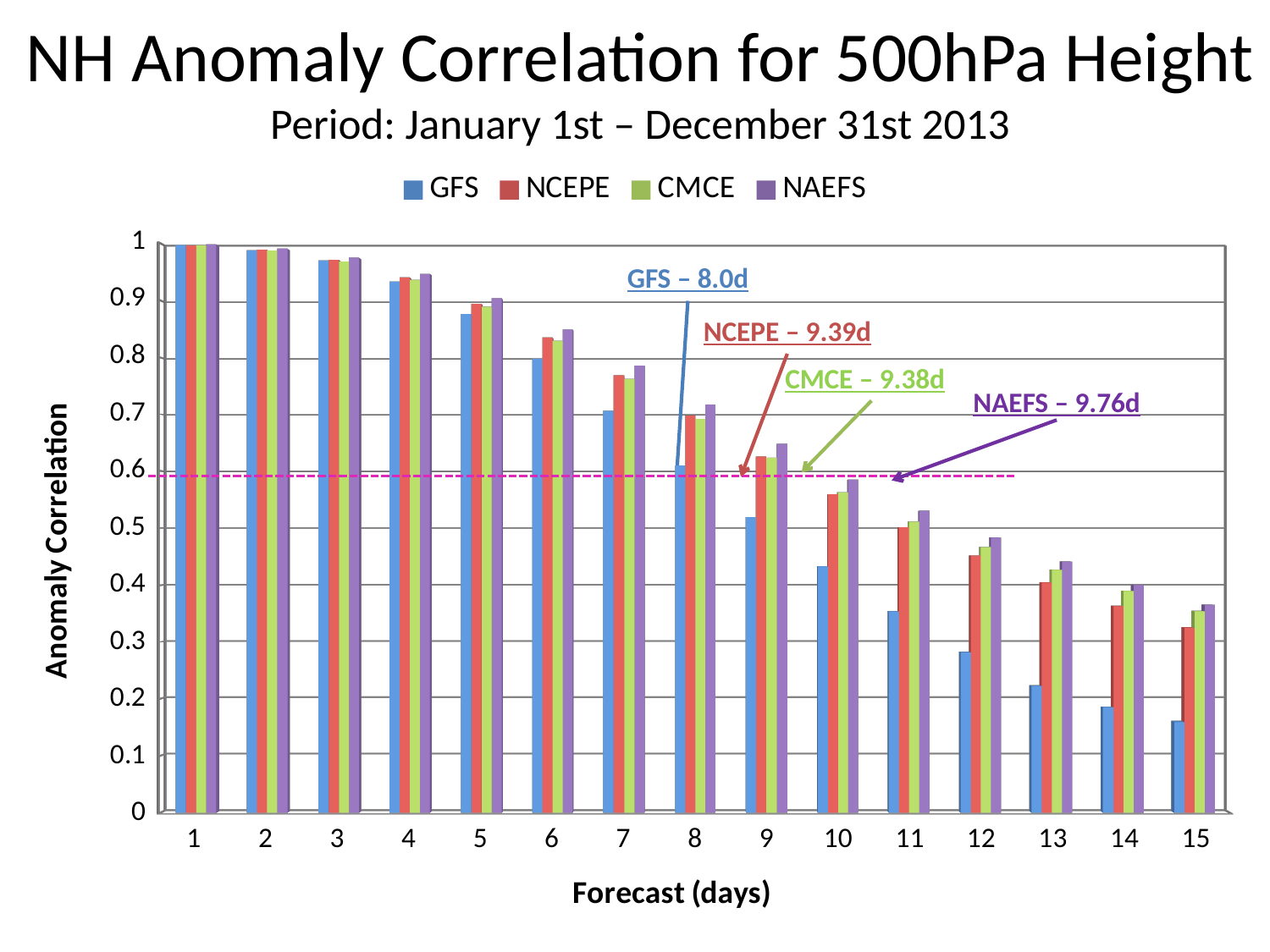
What kind of chart is shown on the slide? Bar chart Is the NAEFS value at forecast day 9 greater or less than 0.6? greater Is the NCEPE value at forecast day 15 greater or less than 0.3? greater At which forecast day is the GFS value lowest? 15 Do the anomaly correlation values rise or fall as the forecast day increases? Fall At forecast day 15, which is larger, the GFS value or the NAEFS value? NAEFS Is the GFS value at forecast day 11 greater or less than 0.4? less How many forecast days are shown along the x axis? 15 How many series does the legend list? 4 Which series has the lowest value at forecast day 13? GFS What is the title of the x axis? Forecast (days)